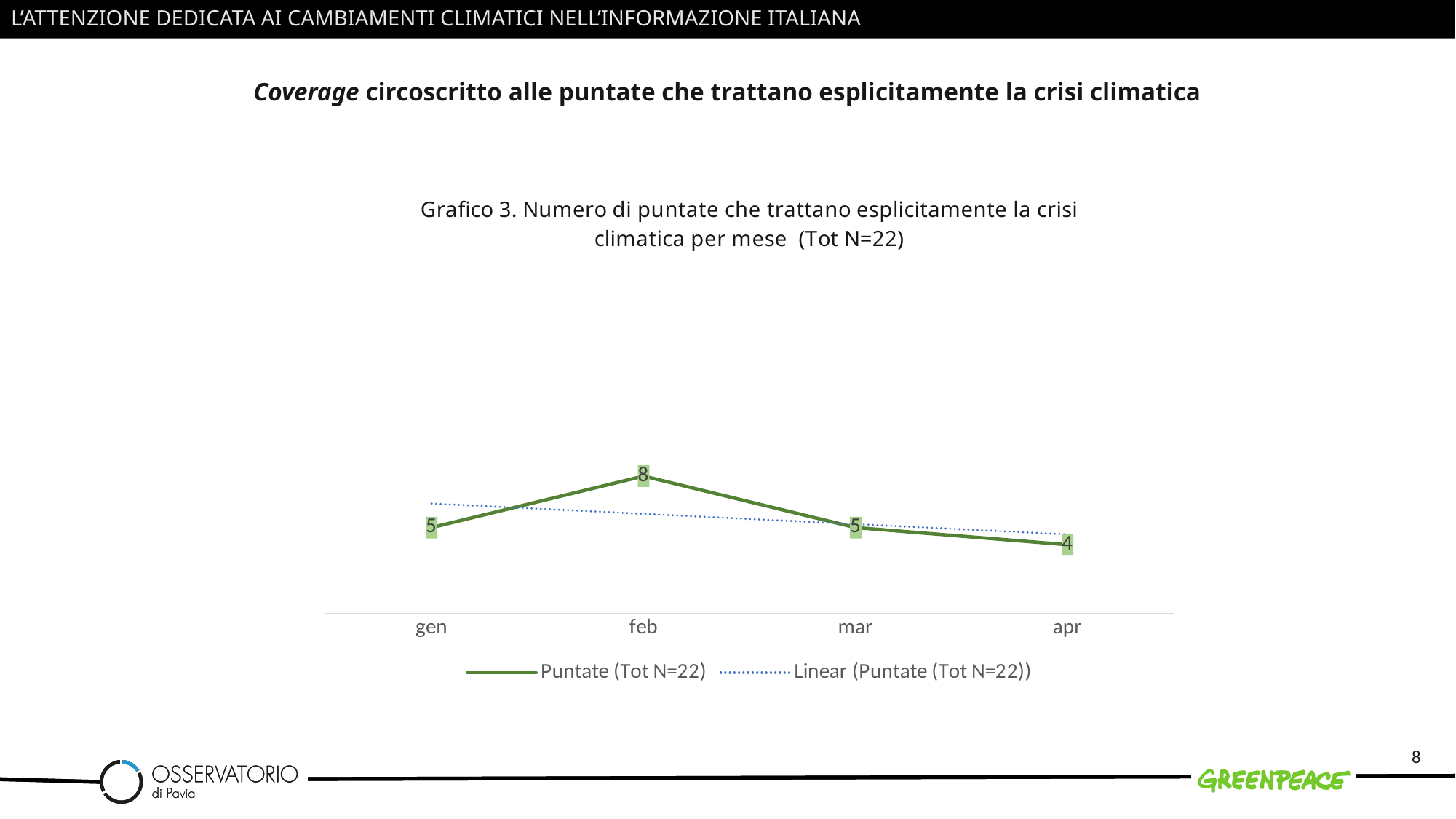
How many months are shown on the x axis? 4 Which month has the lowest number of puntate? apr Which month has more puntate, feb or mar? feb What is the difference between the number of puntate in feb and in apr? 4 Which month has the highest number of puntate? feb What is the number of puntate for gen? 5 What is the total number of puntate across the four months? 22 Do the values of the Puntate series rise or fall from feb to apr? fall What kind of chart is shown on the slide? line chart How many entries does the legend list? 2 What is the number of puntate for apr? 4 What is the number of puntate for feb? 8